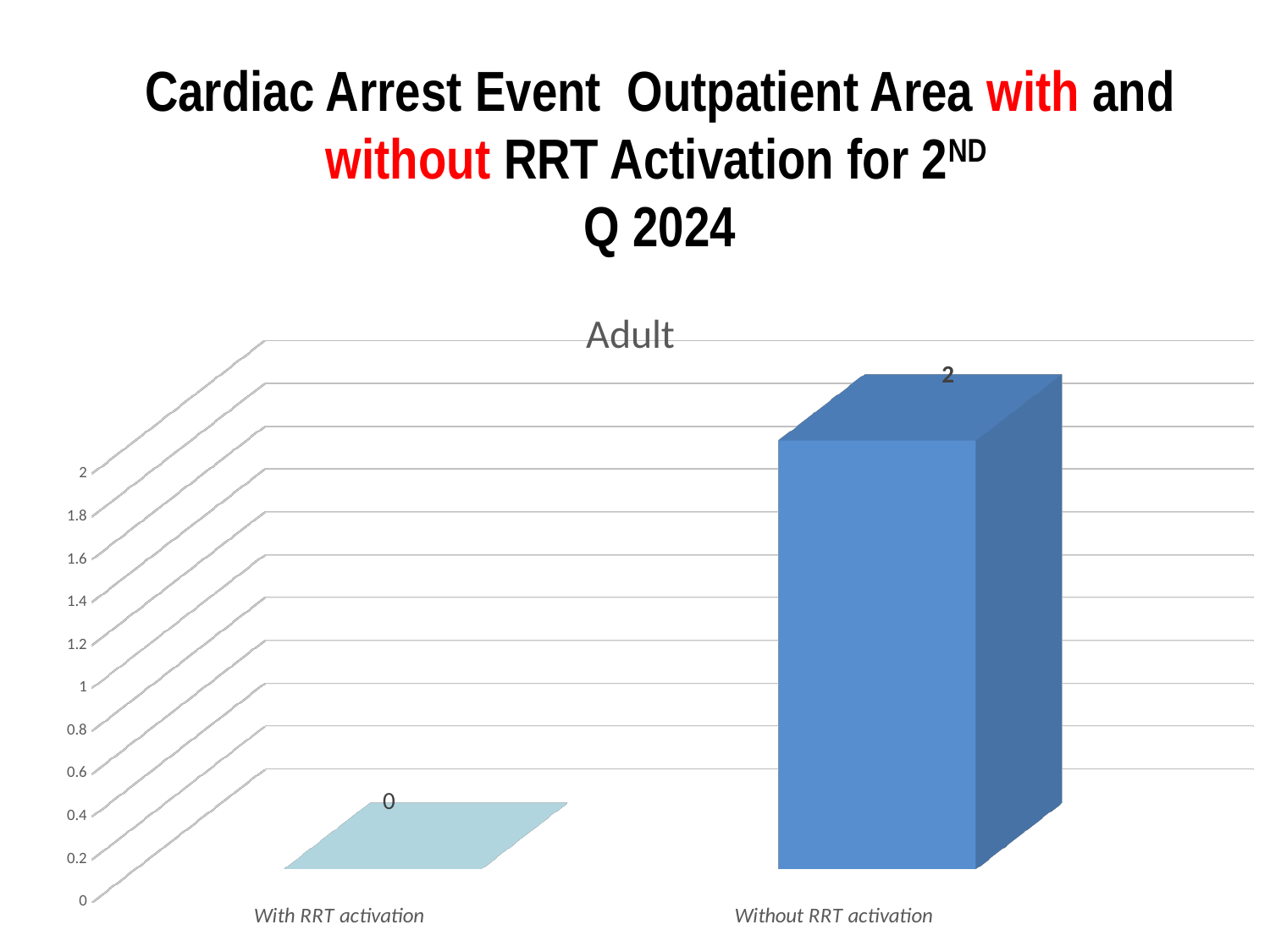
Is the value for 'Without RRT activation' greater or less than 1? greater Do the values rise or fall from left to right along the x axis? rise What is the title of the chart? Adult What is the highest value shown on the vertical axis? 2 What is the value for 'With RRT activation'? 0 What kind of chart is shown on the slide? bar chart Which category has the lowest value? With RRT activation What is the value for 'Without RRT activation'? 2 Which is larger, the value for 'With RRT activation' or 'Without RRT activation'? Without RRT activation How many categories are shown on the x axis? 2 Which category has the highest value? Without RRT activation What is the difference between the values for 'Without RRT activation' and 'With RRT activation'? 2